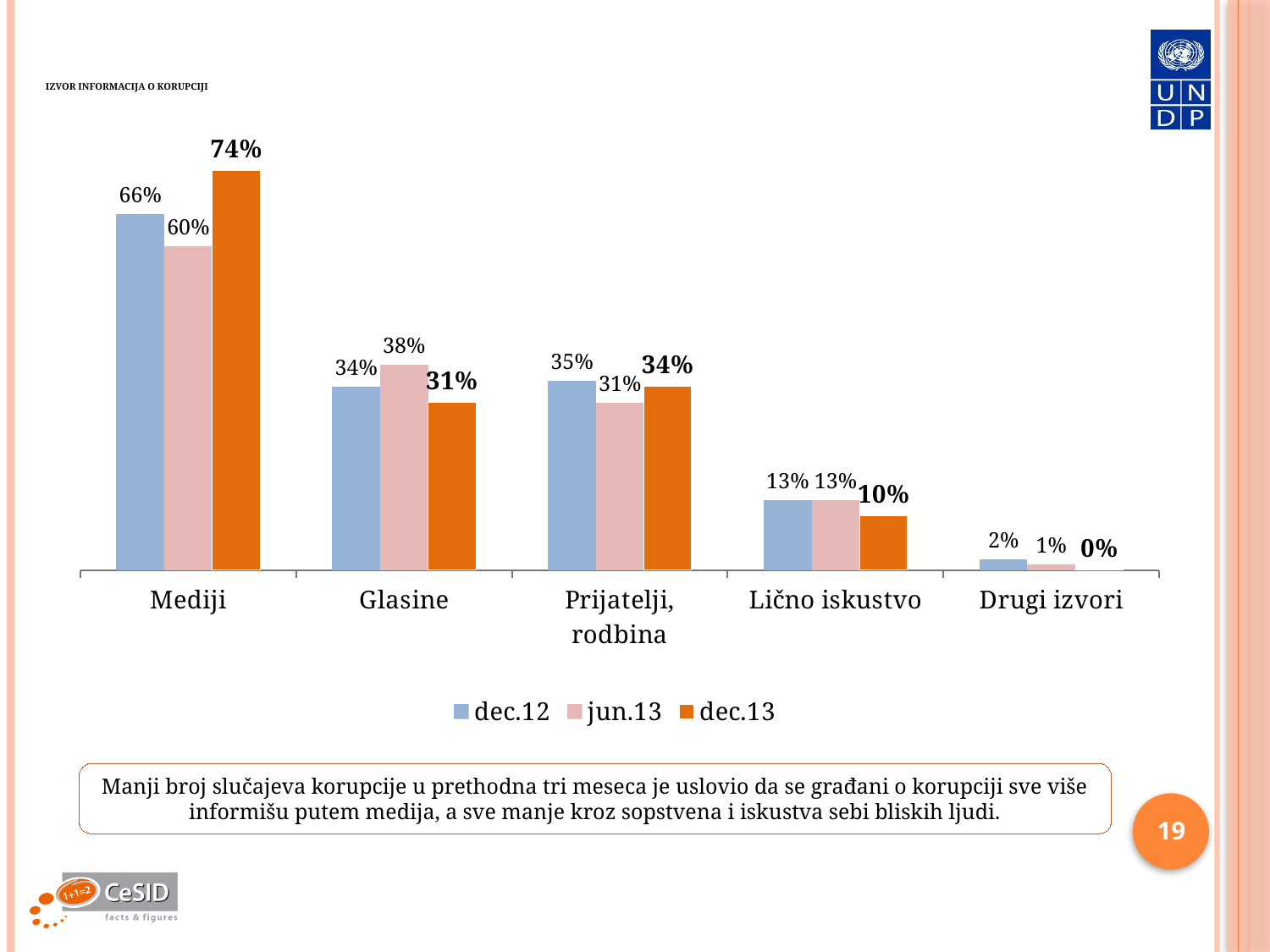
Which category has the highest value in the dec.13 series? Mediji What kind of chart is shown on the slide? bar chart What is the value for Glasine in the jun.13 series? 38% What is the value for Drugi izvori in the dec.13 series? 0% What is the title of the chart? IZVOR INFORMACIJA O KORUPCIJI Which is larger for Prijatelji, rodbina: the dec.12 value or the jun.13 value? dec.12 How many series does the legend list? 3 How many categories are shown on the x axis? 5 What is the value for Mediji in the dec.13 series? 74% Which category has the lowest value in the jun.13 series? Drugi izvori What is the difference between the dec.13 and dec.12 values for Mediji? 8% What is the value for Lično iskustvo in the dec.12 series? 13%